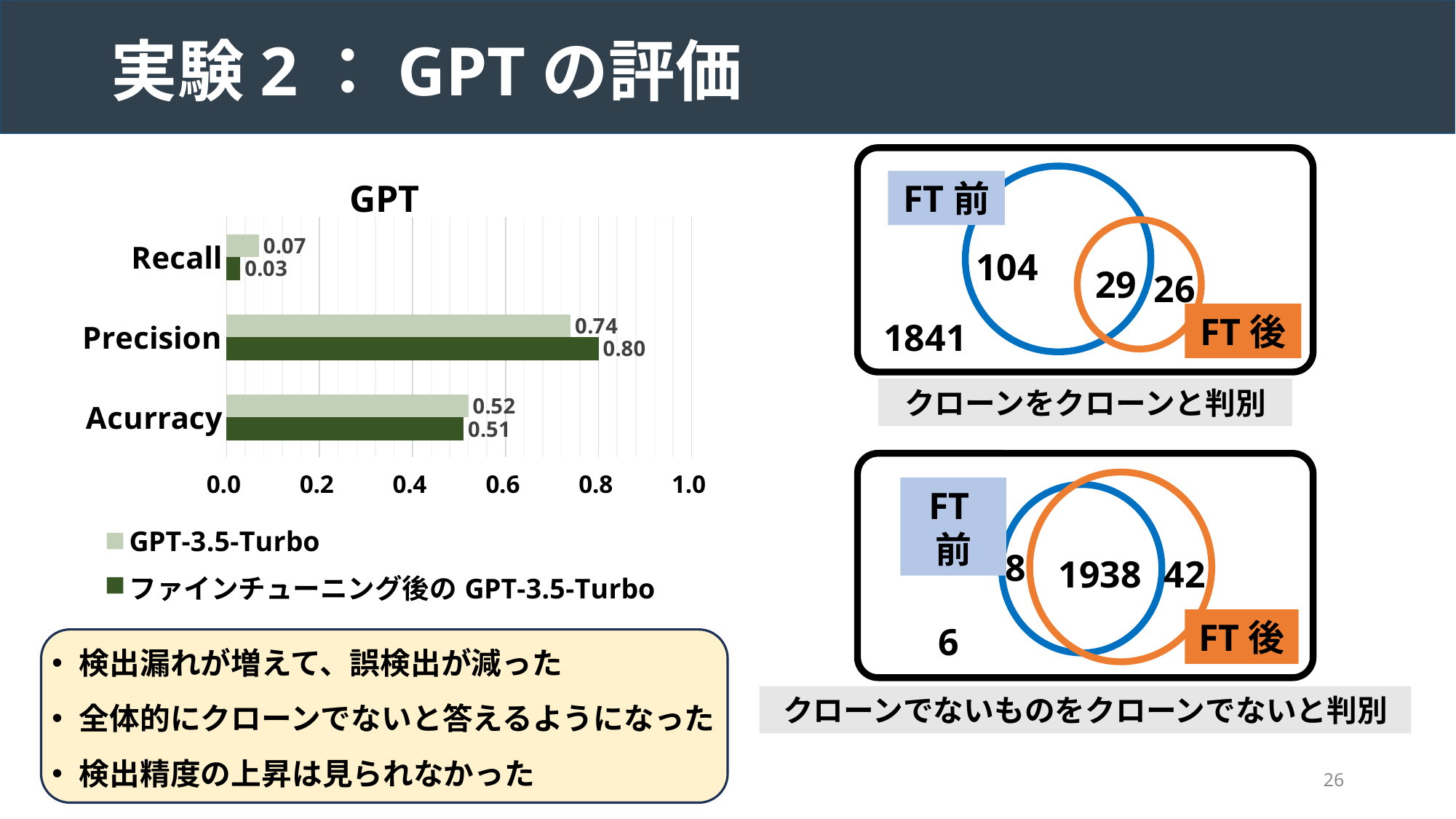
In the GPT chart, what is the Recall value for GPT-3.5-Turbo? 0.07 In the GPT chart, what is the Acurracy value for GPT-3.5-Turbo? 0.52 In the GPT chart, which series has the larger Recall value, GPT-3.5-Turbo or ファインチューニング後の GPT-3.5-Turbo? GPT-3.5-Turbo In the GPT chart, which metric has the highest value for GPT-3.5-Turbo? Precision In the GPT chart, which metric has the lowest value for ファインチューニング後の GPT-3.5-Turbo? Recall In the GPT chart, is the Precision value for GPT-3.5-Turbo greater or less than 0.6? greater In the GPT chart, what is the difference between the Precision values of ファインチューニング後の GPT-3.5-Turbo and GPT-3.5-Turbo? 0.06 How many metric categories are shown in the GPT chart? 3 In the GPT chart, what is the Recall value for ファインチューニング後の GPT-3.5-Turbo? 0.03 How many series does the legend of the GPT chart list? 2 What type of chart is the GPT chart? Bar chart In the GPT chart, what is the Precision value for ファインチューニング後の GPT-3.5-Turbo? 0.80